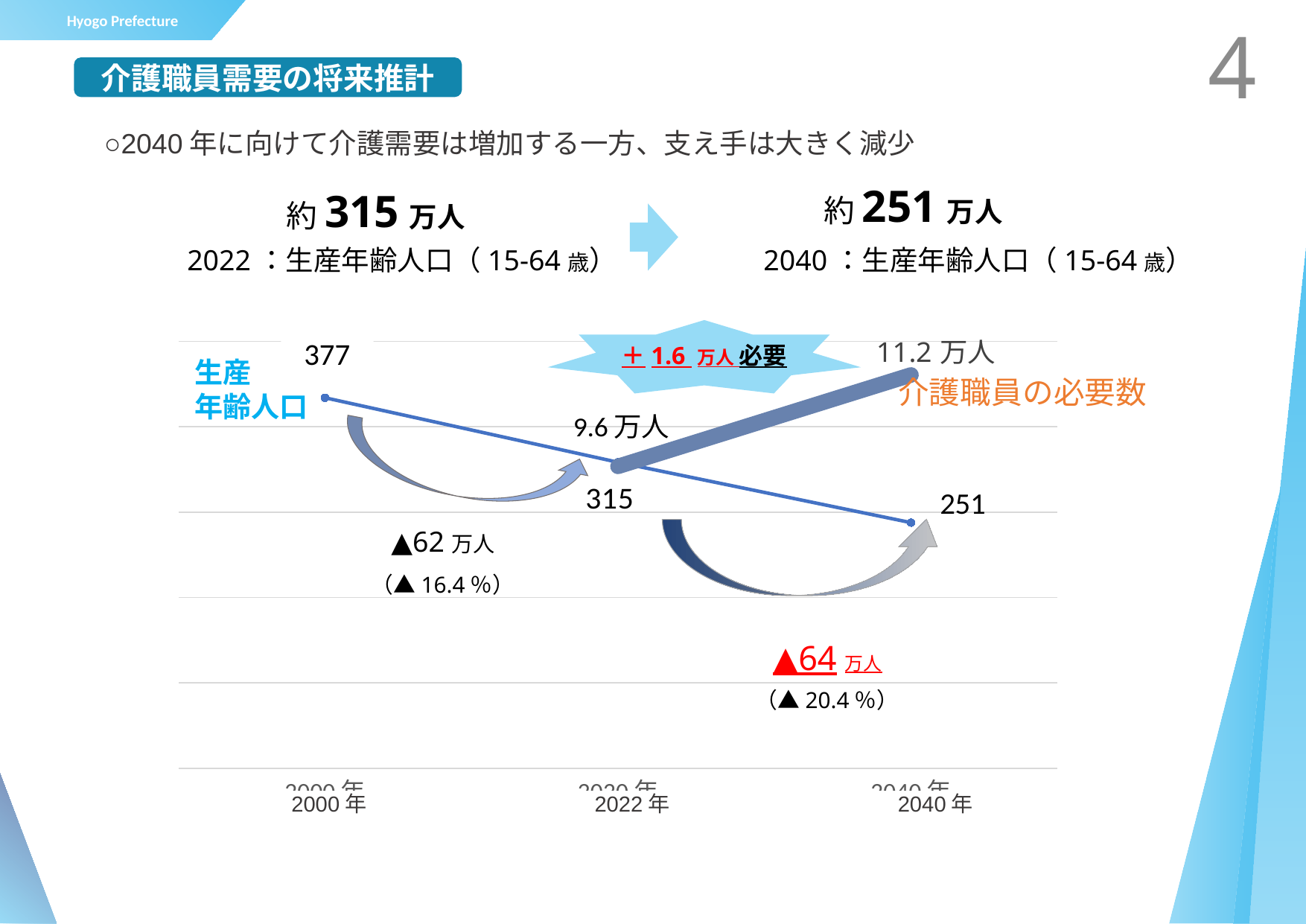
What is the value of 生産年齢人口 for 2040年? 251 By how much does 生産年齢人口 fall from 2022年 to 2040年? 64 What is the value of 生産年齢人口 for 2022年? 315 What percentage decrease in 生産年齢人口 is shown between 2000年 and 2022年? ▲16.4% What is the 介護職員の必要数 for 2022年? 9.6万人 By how much does 介護職員の必要数 increase from 2022年 to 2040年? 1.6万人 Does 介護職員の必要数 rise or fall from 2022年 to 2040年? rise Does 生産年齢人口 rise or fall from 2000年 to 2040年? fall In which year is 生産年齢人口 lowest? 2040年 In which year is 生産年齢人口 highest? 2000年 What is the value of 生産年齢人口 for 2000年? 377 What is the 介護職員の必要数 for 2040年? 11.2万人